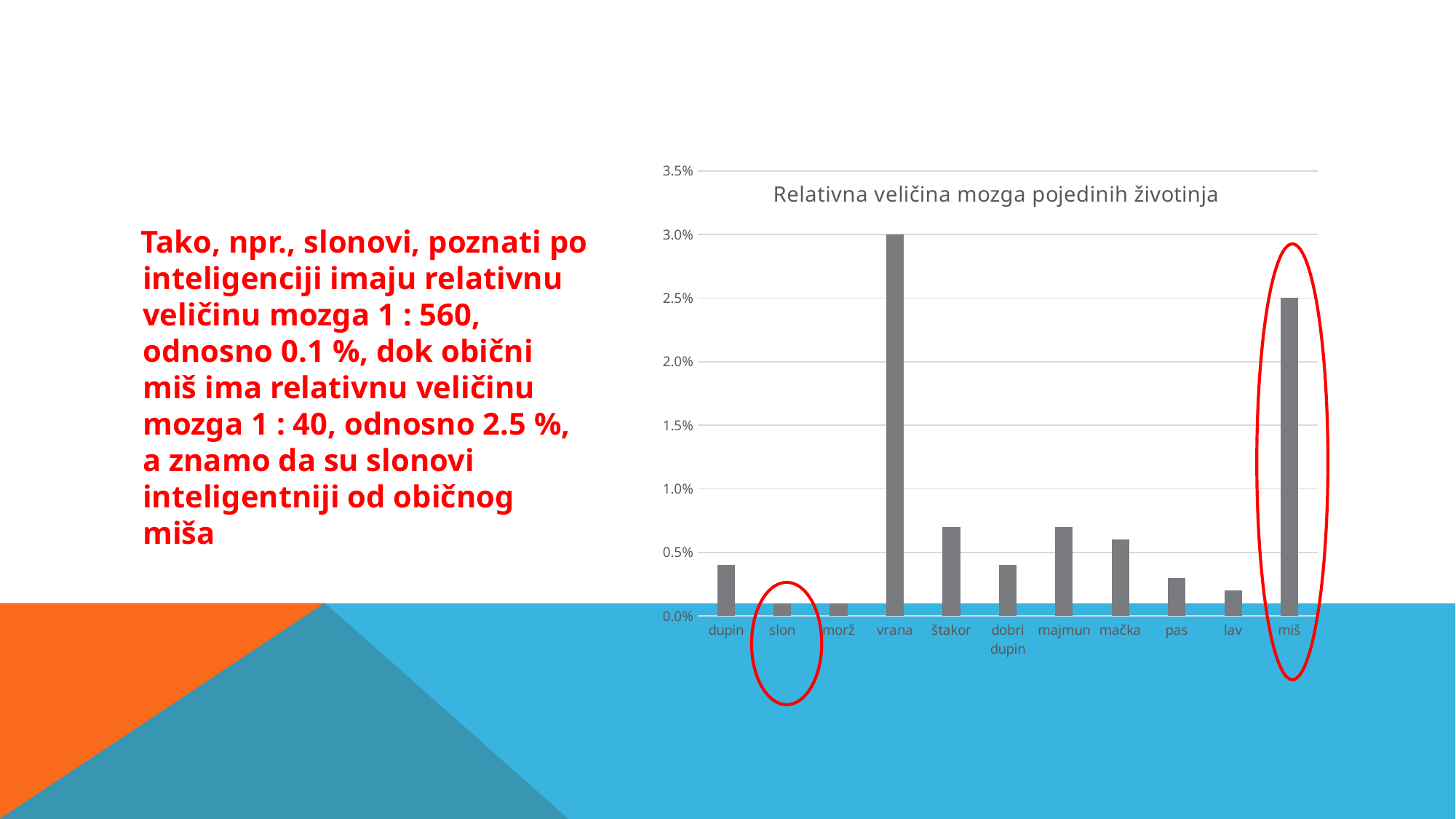
What is the relative brain size value for vrana? 3.0% What kind of chart is shown on the slide? bar chart Which has a larger value, dupin or lav? dupin What is the relative brain size value for miš? 2.5% Which animal has the highest relative brain size in the chart? vrana Is the value for pas greater or less than 0.5%? less What is the difference between the values for vrana and miš? 0.5% What is the title of the chart? Relativna veličina mozga pojedinih životinja How many animal categories are shown on the x axis of the chart? 11 Is the value for štakor greater or less than 0.5%? greater Which has a larger value, štakor or pas? štakor Which two categories on the chart are circled in red? slon and miš